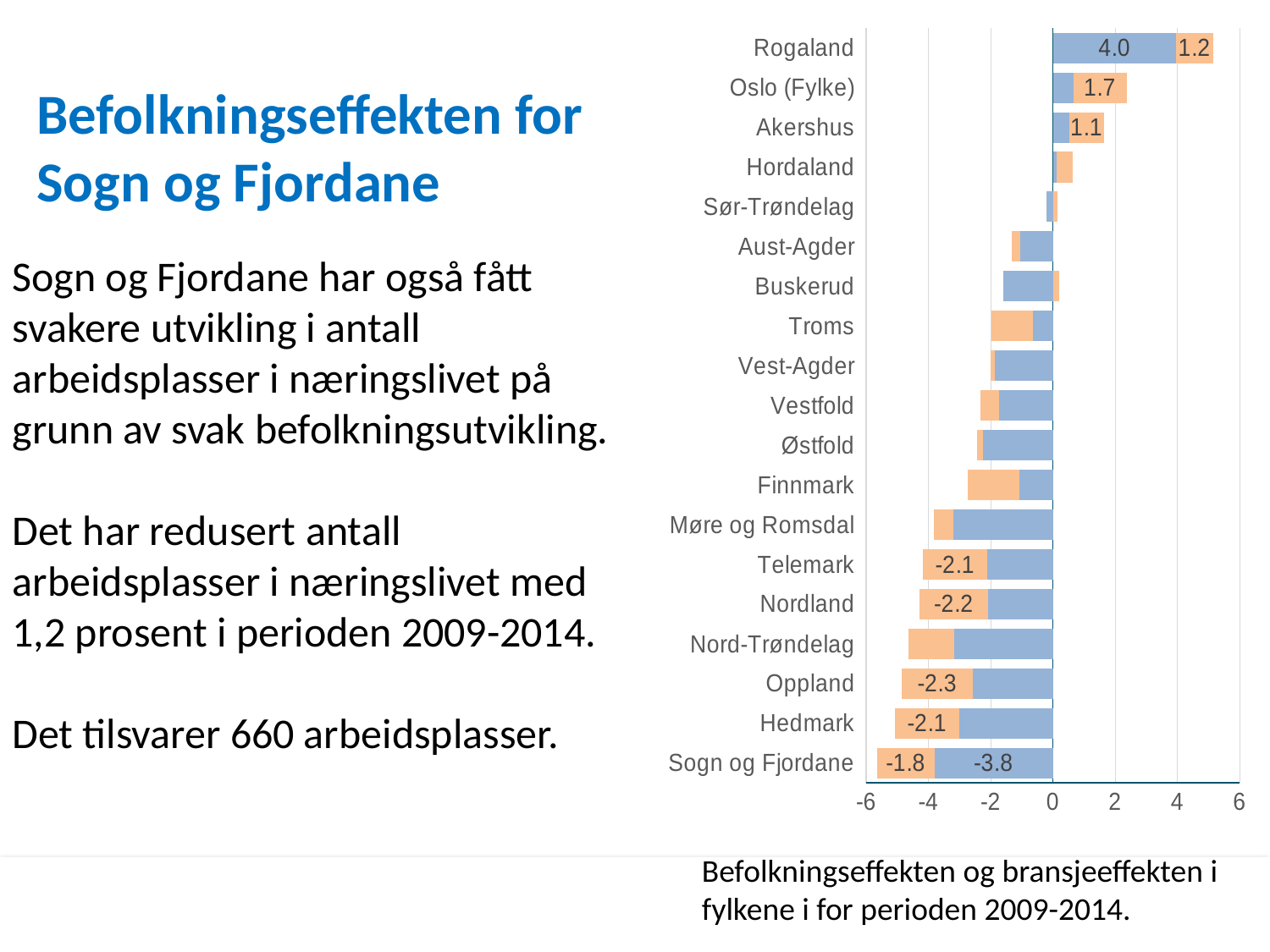
How many fylker (categories) are listed on the chart? 19 Which has the larger orange segment value, Oslo (Fylke) or Akershus? Oslo (Fylke) Which fylke has the highest total bar value? Rogaland What is the value of the orange segment for Oppland? -2.3 What is the value of the blue segment for Sogn og Fjordane? -3.8 Which fylke has the lowest total bar value? Sogn og Fjordane What is the total of the stacked bar for Rogaland? 5.2 What kind of chart is shown on the slide? bar chart What is the total of the stacked bar for Sogn og Fjordane? -5.6 What is the value of the blue segment for Rogaland? 4.0 Is the total bar value for Nord-Trøndelag greater or less than -4? less What is the value of the orange segment for Rogaland? 1.2